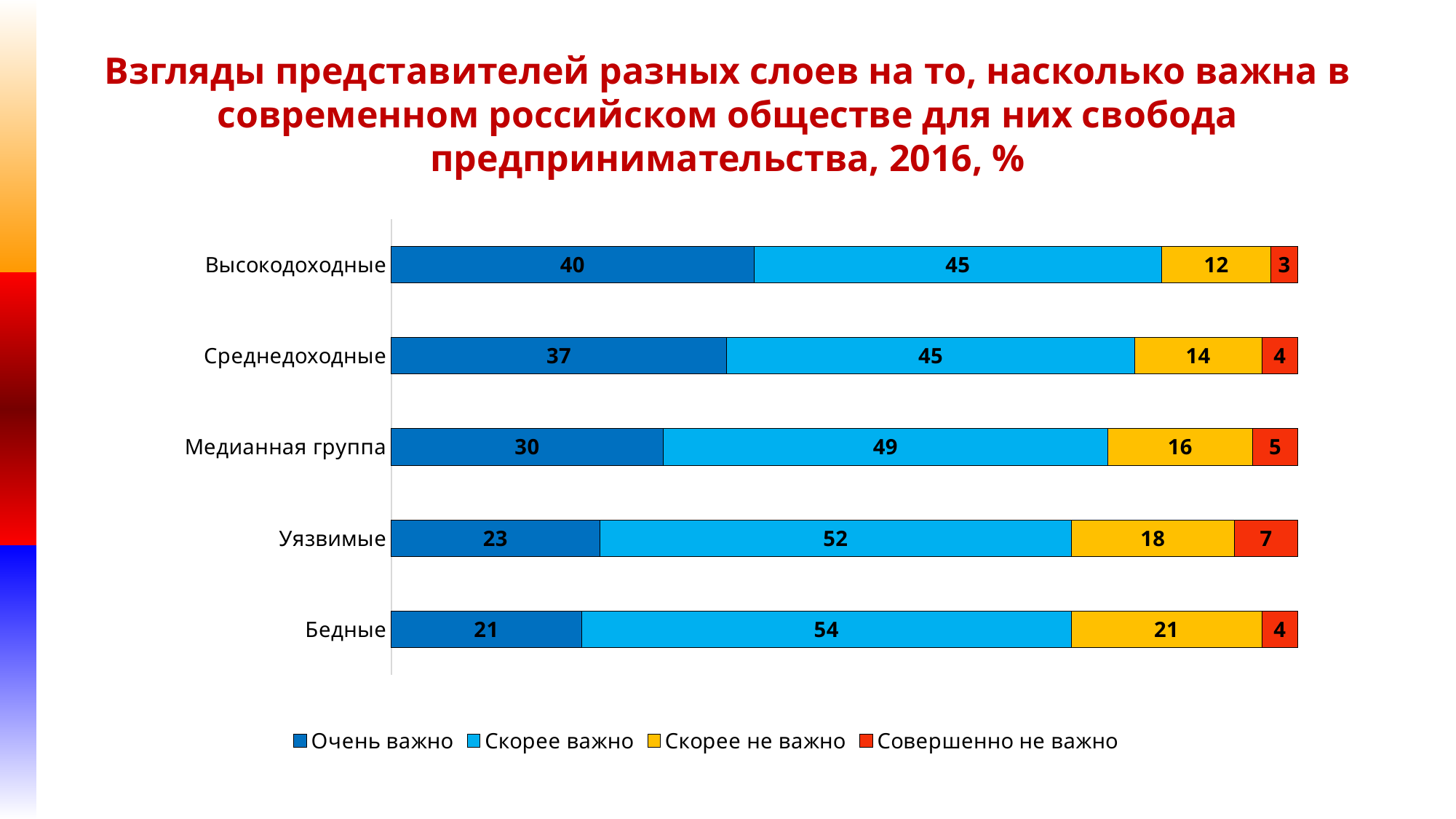
How many groups (categories) are shown on the chart? 5 What is the value of "Скорее не важно" for Медианная группа? 16 What is the total of the stacked bar for Медианная группа? 100 What is the value of "Совершенно не важно" for Уязвимые? 7 Which group has the lowest value for "Скорее важно"? Высокодоходные and Среднедоходные (45) What is the value of "Очень важно" for Высокодоходные? 40 How many series does the legend list? 4 Which group has the highest value for "Очень важно"? Высокодоходные What is the value of "Скорее важно" for Бедные? 54 What is the difference between the "Очень важно" values for Высокодоходные and Бедные? 19 What kind of chart is shown on the slide? Stacked bar chart Which is larger: "Скорее не важно" for Уязвимые or for Среднедоходные? Уязвимые